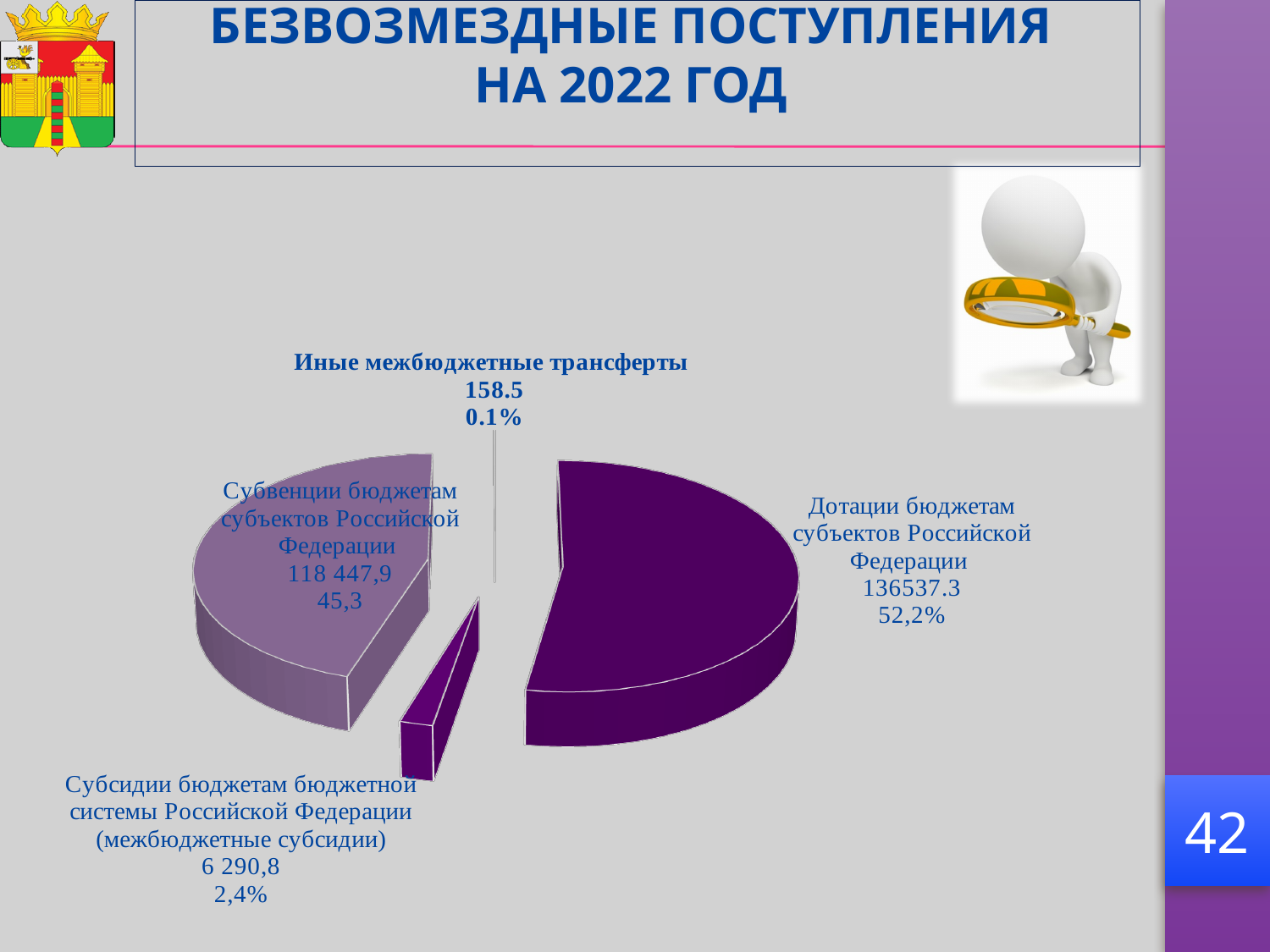
What is the value shown for Дотации бюджетам субъектов Российской Федерации? 136537.3 What share of the pie do Субсидии бюджетам бюджетной системы Российской Федерации (межбюджетные субсидии) represent? 2,4% Which category has the largest share of the pie? Дотации бюджетам субъектов Российской Федерации What kind of chart is shown on the slide? Pie chart What share of the pie do Дотации бюджетам субъектов Российской Федерации represent? 52,2% What is the value shown for Иные межбюджетные трансферты? 158.5 Which category has the smallest share of the pie? Иные межбюджетные трансферты What is the value shown for Субвенции бюджетам субъектов Российской Федерации? 118 447,9 Which is larger: the value for Субвенции бюджетам субъектов Российской Федерации or for Субсидии бюджетам бюджетной системы Российской Федерации? Субвенции бюджетам субъектов Российской Федерации What is the value shown for Субсидии бюджетам бюджетной системы Российской Федерации (межбюджетные субсидии)? 6 290,8 What is the title of the slide containing the pie chart? БЕЗВОЗМЕЗДНЫЕ ПОСТУПЛЕНИЯ НА 2022 ГОД How many categories (slices) does the pie chart have? 4